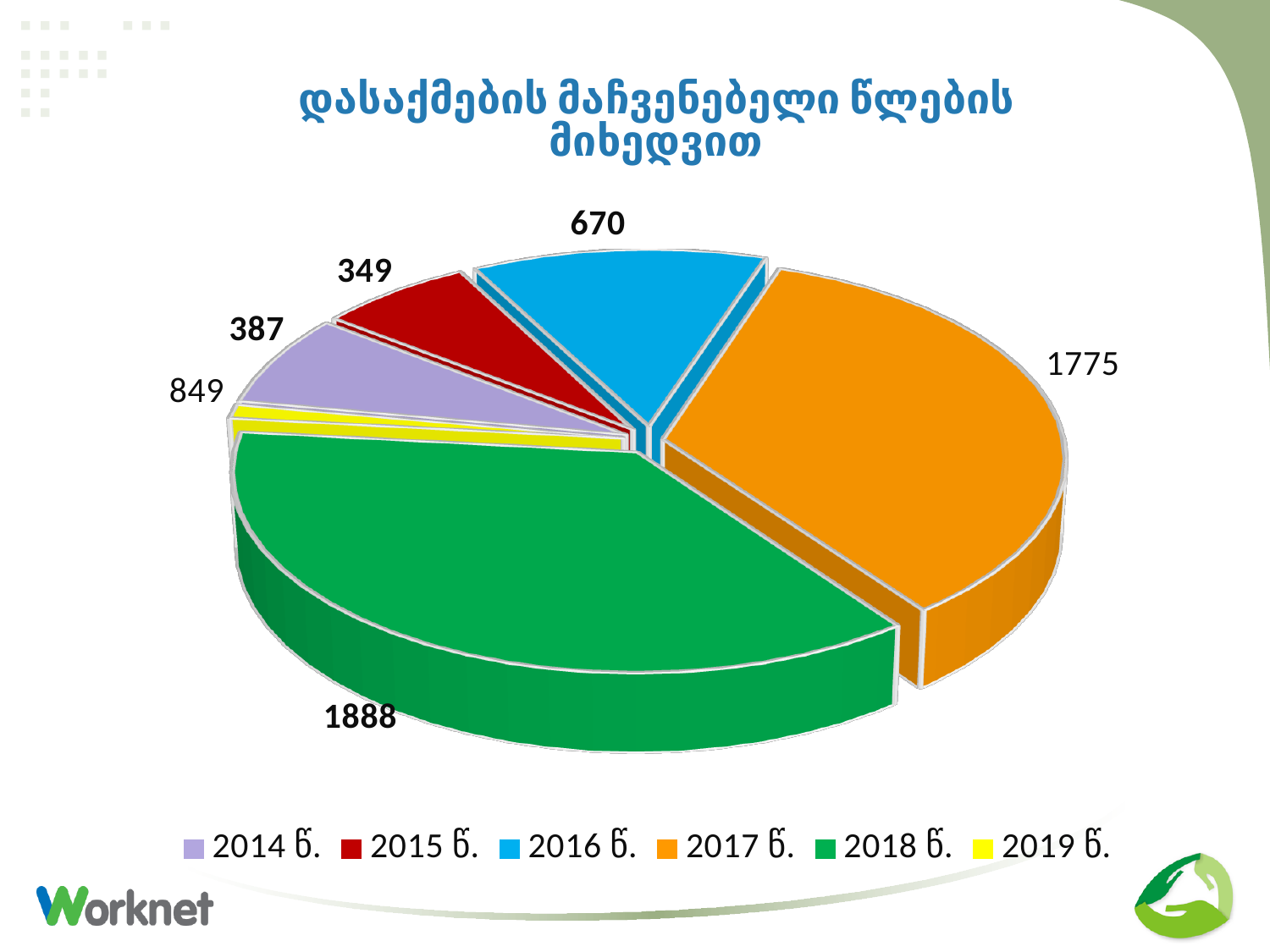
What is the difference between the values for 2014 წ. and 2015 წ.? 38 What is the value for 2014 წ.? 387 What is the value for 2017 წ.? 1775 What colour is the slice for 2018 წ.? green What kind of chart is shown on the slide? pie chart Which is larger, the value for 2016 წ. or the value for 2015 წ.? 2016 წ. What is the value for 2018 წ.? 1888 What is the value for 2016 წ.? 670 What is the difference between the values for 2018 წ. and 2017 წ.? 113 Which year has the largest slice? 2018 წ. How many entries does the legend list? 6 What is the value for 2015 წ.? 349